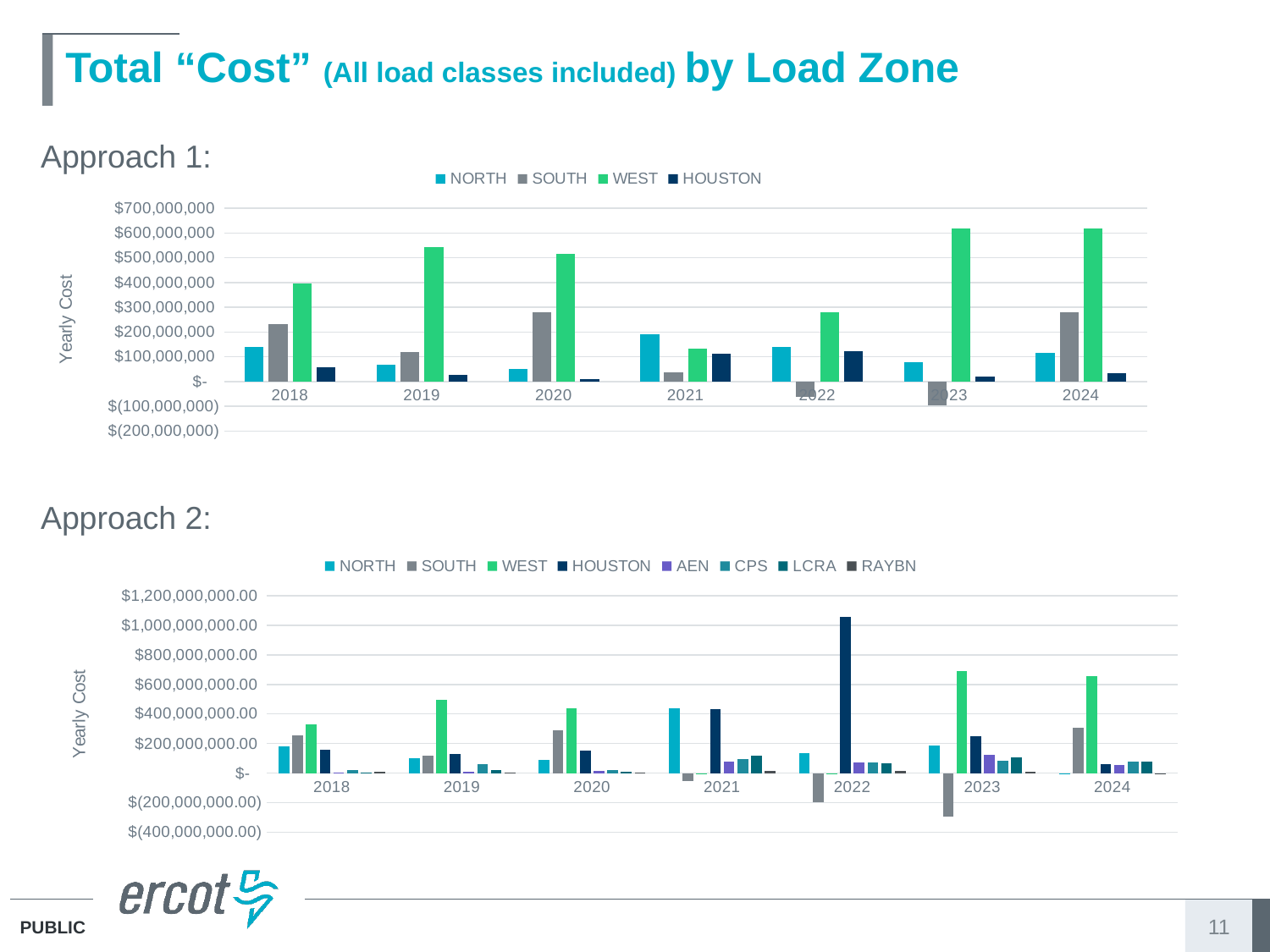
In the Approach 1 chart, which load zone has the lowest value in 2023? SOUTH What kind of chart is the Approach 2 chart? Bar chart In the Approach 2 chart, is the value for HOUSTON in 2022 greater or less than $1,000,000,000.00? greater In the Approach 1 chart, how many series does the legend list? 4 In the Approach 1 chart, is the value for NORTH in 2021 greater or less than $100,000,000? greater In the Approach 2 chart, which load zone has the highest value in 2022? HOUSTON In the Approach 2 chart, which is larger in 2023: WEST or HOUSTON? WEST In the Approach 2 chart, how many series does the legend list? 8 In the Approach 1 chart, is the value for WEST in 2019 greater or less than $500,000,000? greater In the Approach 1 chart, how many years are shown on the x axis? 7 In the Approach 1 chart, which load zone has the highest value in 2019? WEST